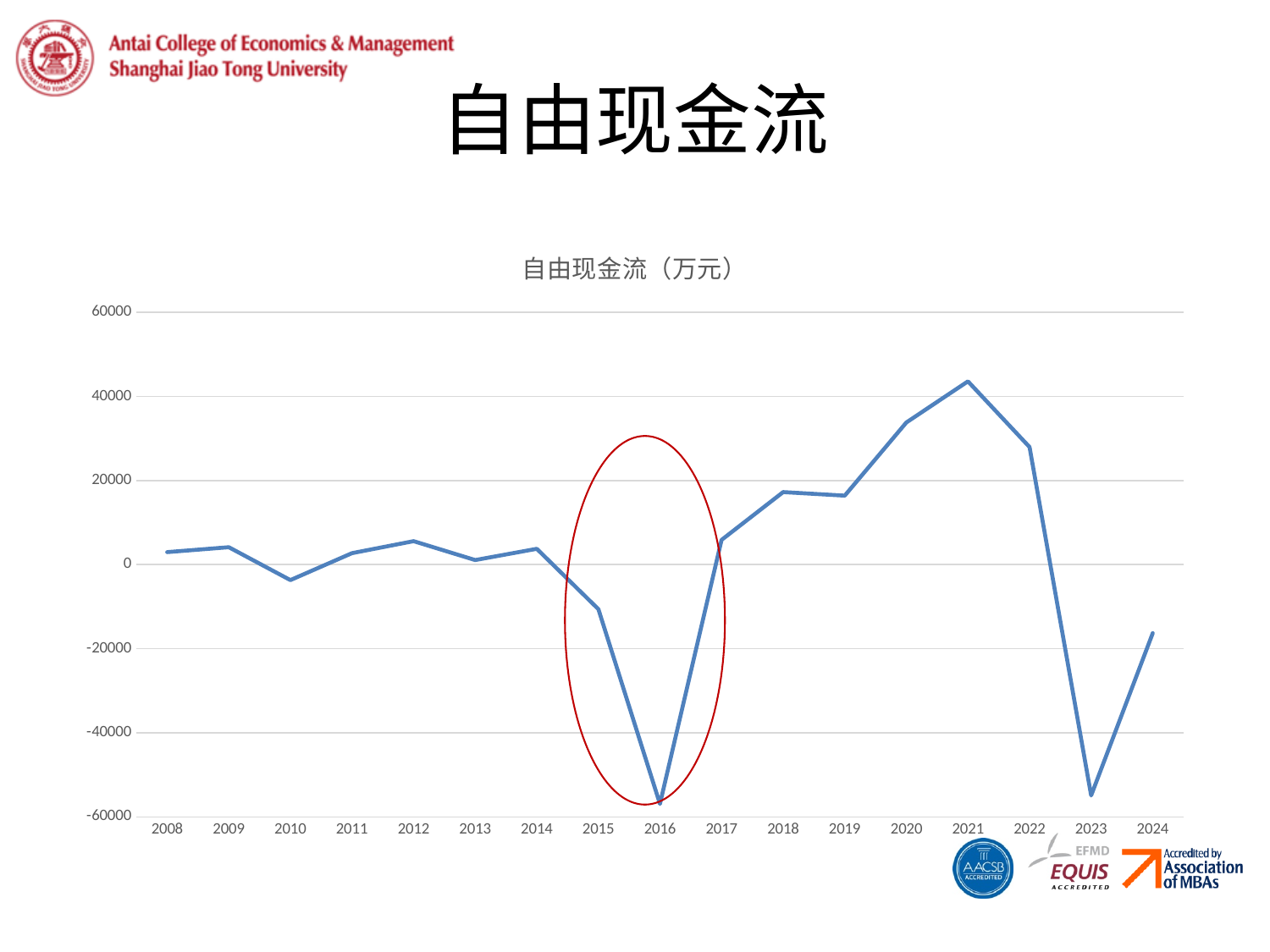
Which year has the larger value, 2021 or 2022? 2021 Is the value for 2018 greater or less than 20000? less What is the title of the chart? 自由现金流（万元） How many years are plotted on the x axis of the chart? 17 What kind of chart is shown on the slide? line chart Which year has the larger value, 2009 or 2010? 2009 Which year has the highest free cash flow value in the chart? 2021 Is the value for 2016 greater or less than -40000? less Is the value for 2024 greater or less than 0? less Do the values rise or fall from 2019 to 2021? rise Which year's data point is highlighted with a red circle on the chart? 2016